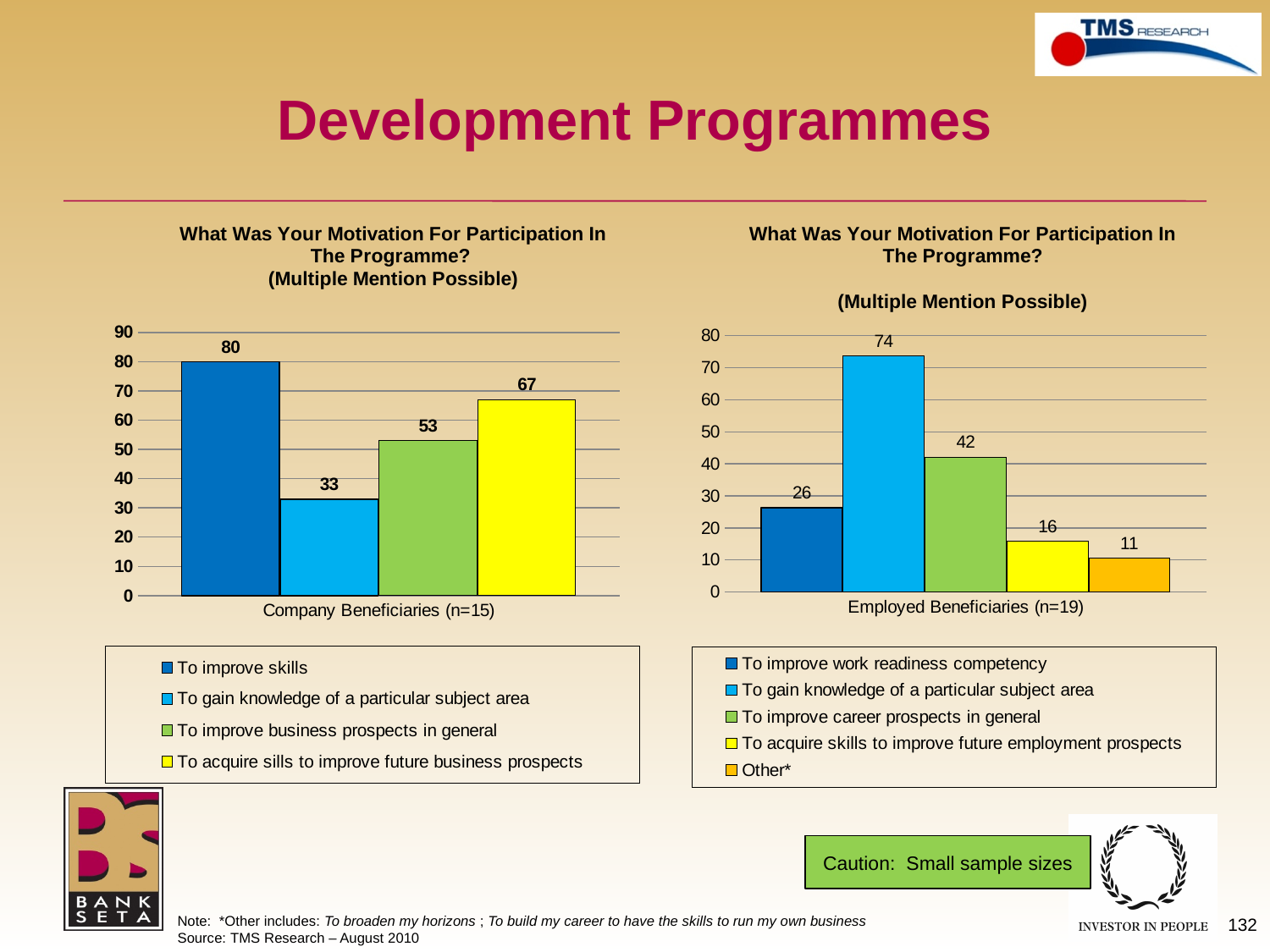
In the right chart (Employed Beneficiaries), which is larger: 'To improve work readiness competency' or 'To acquire skills to improve future employment prospects'? To improve work readiness competency In the right chart (Employed Beneficiaries), which motivation has the highest value? To gain knowledge of a particular subject area In the right chart (Employed Beneficiaries), what is the value for 'Other*'? 11 What type of chart is the left chart (Company Beneficiaries)? Bar chart In the right chart (Employed Beneficiaries), what is the difference between 'To gain knowledge of a particular subject area' and 'To improve career prospects in general'? 32 In the left chart (Company Beneficiaries), what is the value for 'To improve skills'? 80 In the left chart (Company Beneficiaries), how many series does the legend list? 4 In the left chart (Company Beneficiaries), what is the value for 'To acquire sills to improve future business prospects'? 67 In the right chart (Employed Beneficiaries), how many series does the legend list? 5 In the left chart (Company Beneficiaries), what is the difference between 'To improve skills' and 'To improve business prospects in general'? 27 In the right chart (Employed Beneficiaries), what is the value for 'To gain knowledge of a particular subject area'? 74 In the left chart (Company Beneficiaries), which motivation has the lowest value? To gain knowledge of a particular subject area